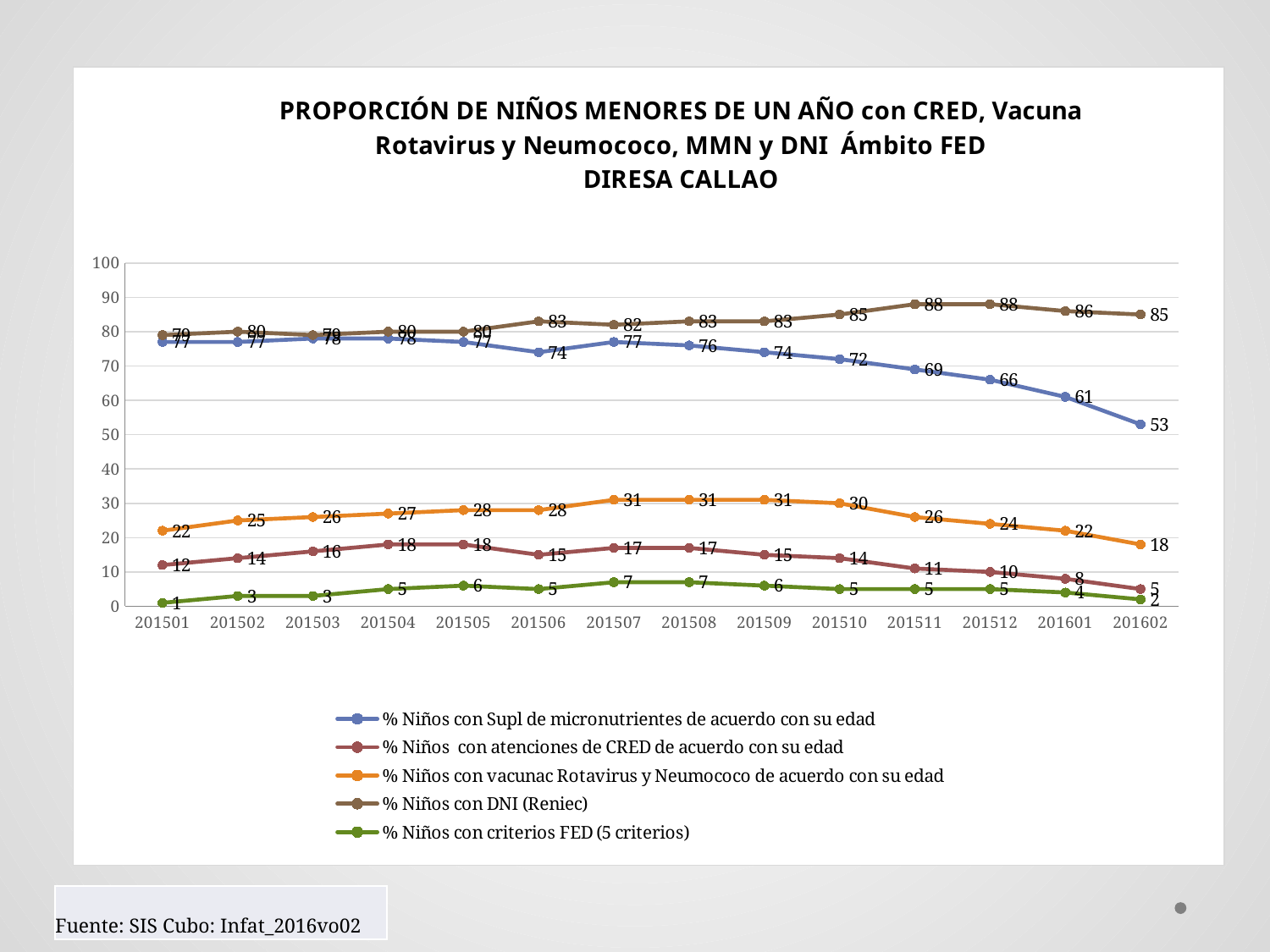
What is the difference between % Niños con DNI (Reniec) and % Niños con Supl de micronutrientes de acuerdo con su edad in 201602? 32 What is the value for % Niños con criterios FED (5 criterios) in 201508? 7 What is the source cited at the bottom of the slide? SIS Cubo: Infat_2016vo02 What kind of chart is shown on the slide? line chart Does % Niños con Supl de micronutrientes de acuerdo con su edad rise or fall from 201509 to 201602? fall Which is larger in 201510: % Niños con vacunac Rotavirus y Neumococo de acuerdo con su edad or % Niños con atenciones de CRED de acuerdo con su edad? % Niños con vacunac Rotavirus y Neumococo de acuerdo con su edad How many periods are shown on the x axis? 14 What is the value for % Niños con DNI (Reniec) in 201511? 88 How many series does the legend list? 5 In which period is % Niños con Supl de micronutrientes de acuerdo con su edad lowest? 201602 What is the value for % Niños con Supl de micronutrientes de acuerdo con su edad in 201602? 53 What is the value for % Niños con vacunac Rotavirus y Neumococo de acuerdo con su edad in 201507? 31